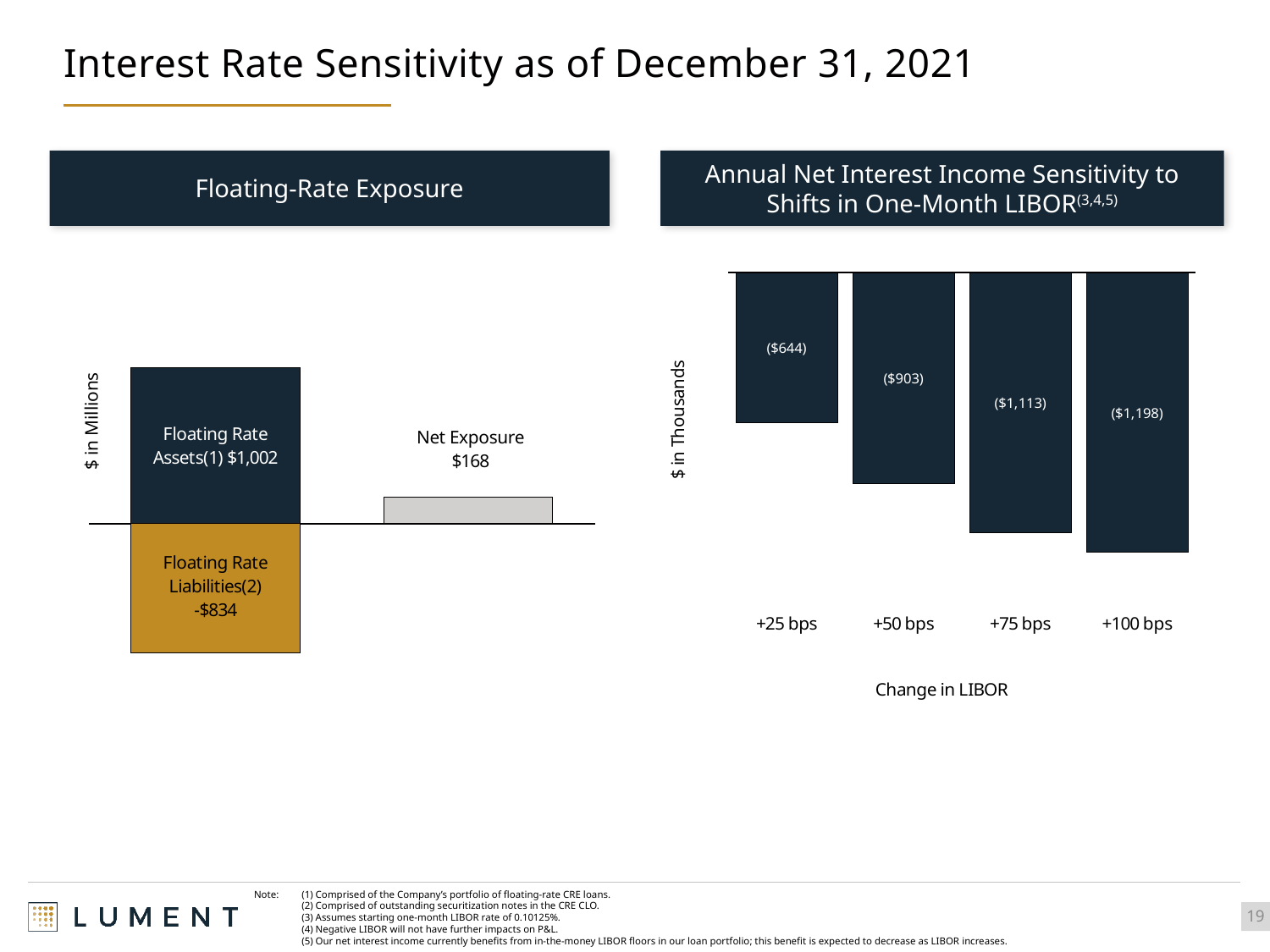
In the Floating-Rate Exposure chart, what is the value for Floating Rate Assets? $1,002 In the Annual Net Interest Income Sensitivity chart, what is the difference between the +100 bps value and the +25 bps value? $554 In the Annual Net Interest Income Sensitivity chart, which LIBOR change shows the largest reduction in net interest income? +100 bps In the Annual Net Interest Income Sensitivity chart, what is the value for +25 bps? ($644) How many LIBOR change categories are shown in the Annual Net Interest Income Sensitivity chart? 4 What is the y-axis label of the Annual Net Interest Income Sensitivity chart? $ in Thousands In the Annual Net Interest Income Sensitivity chart, do the values rise or fall as the change in LIBOR increases from +25 bps to +100 bps? fall What kind of chart is the Annual Net Interest Income Sensitivity chart? bar chart In the Annual Net Interest Income Sensitivity chart, what is the value for +100 bps? ($1,198) In the Annual Net Interest Income Sensitivity chart, what is the value for +50 bps? ($903) In the Floating-Rate Exposure chart, what is the Net Exposure value? $168 In the Floating-Rate Exposure chart, what is the value for Floating Rate Liabilities? -$834